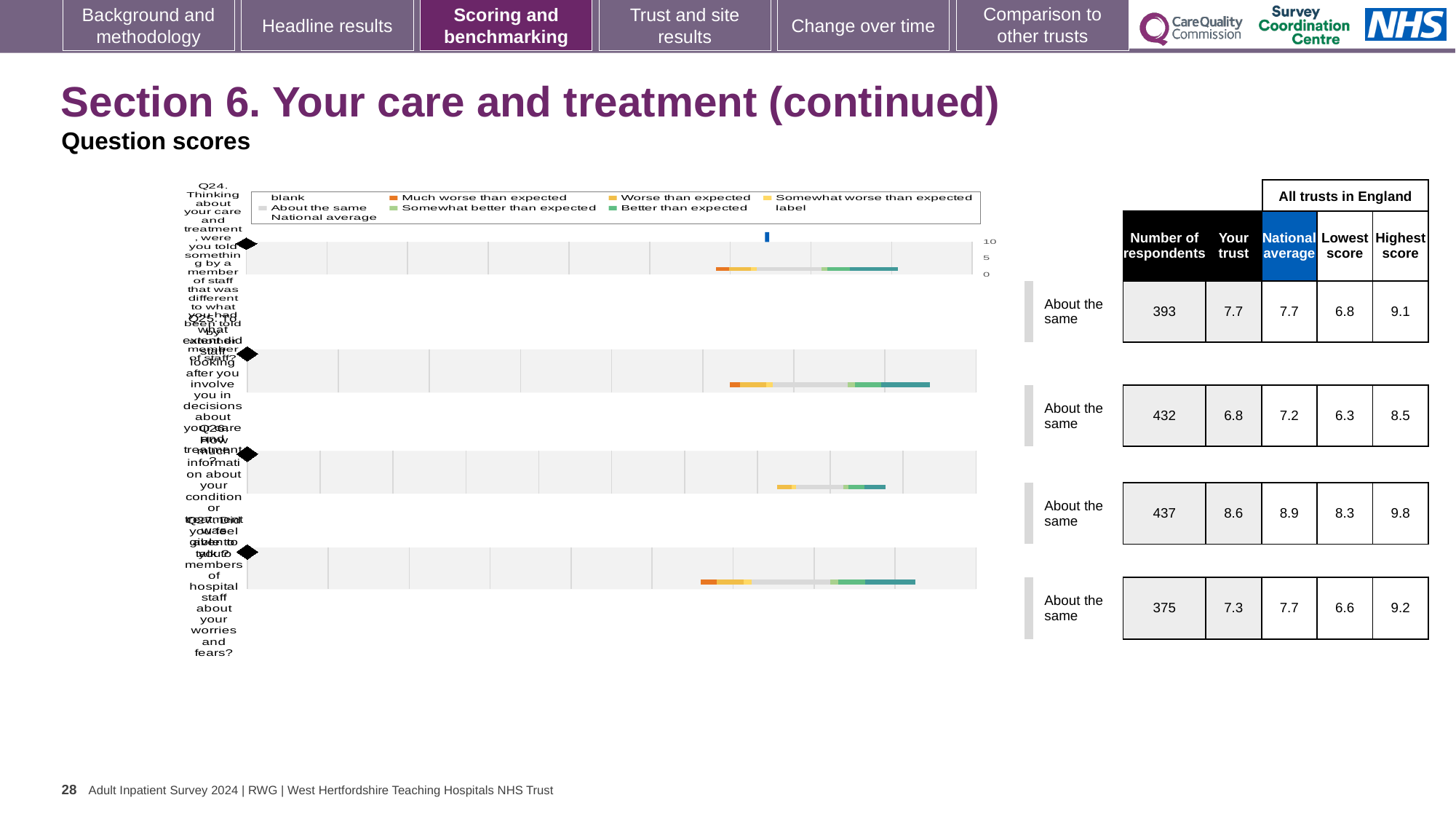
In the table beside the chart, what is the number of respondents for Q24? 393 In the table beside the chart, what is the 'Your trust' score for Q25? 6.8 What kind of chart is shown on the slide? bar chart In the table beside the chart, what is the national average for Q26? 8.9 For Q26, what is the difference between the highest score and the lowest score? 1.5 In the table beside the chart, what is the highest score for Q27? 9.2 In the chart legend, what colour represents 'Much worse than expected'? orange How many question bars (Q24 to Q27) are plotted in the chart? 4 Which question has the highest 'Your trust' score in the table? Q26 For Q25, which is larger: the 'Your trust' score or the national average? National average What benchmark category is shown for Q24? About the same In the chart legend, what colour represents 'Better than expected'? green